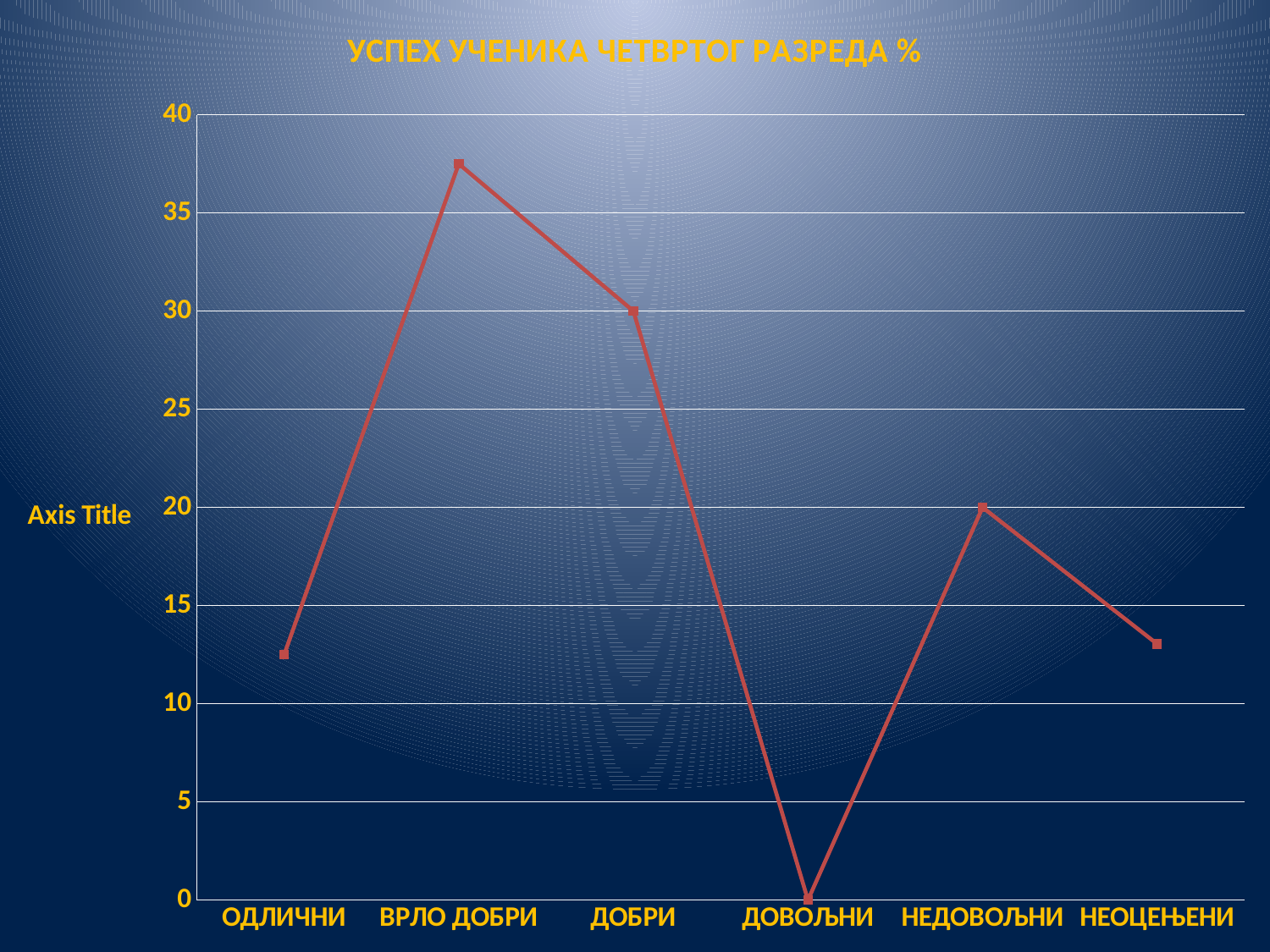
How many categories are plotted along the x axis? 6 What is the value for ДОБРИ? 30 Is the value for ВРЛО ДОБРИ greater or less than 35? greater Which is larger, the value for ДОБРИ or the value for НЕДОВОЉНИ? ДОБРИ Is the value for ОДЛИЧНИ greater or less than 15? less What is the value for НЕДОВОЉНИ? 20 What is the title of the chart? УСПЕХ УЧЕНИКА ЧЕТВРТОГ РАЗРЕДА % Which category has the highest value? ВРЛО ДОБРИ Which category has the lowest value? ДОВОЉНИ What is the value for ДОВОЉНИ? 0 What is the difference between the values for ДОБРИ and НЕДОВОЉНИ? 10 What kind of chart is shown on the slide? line chart